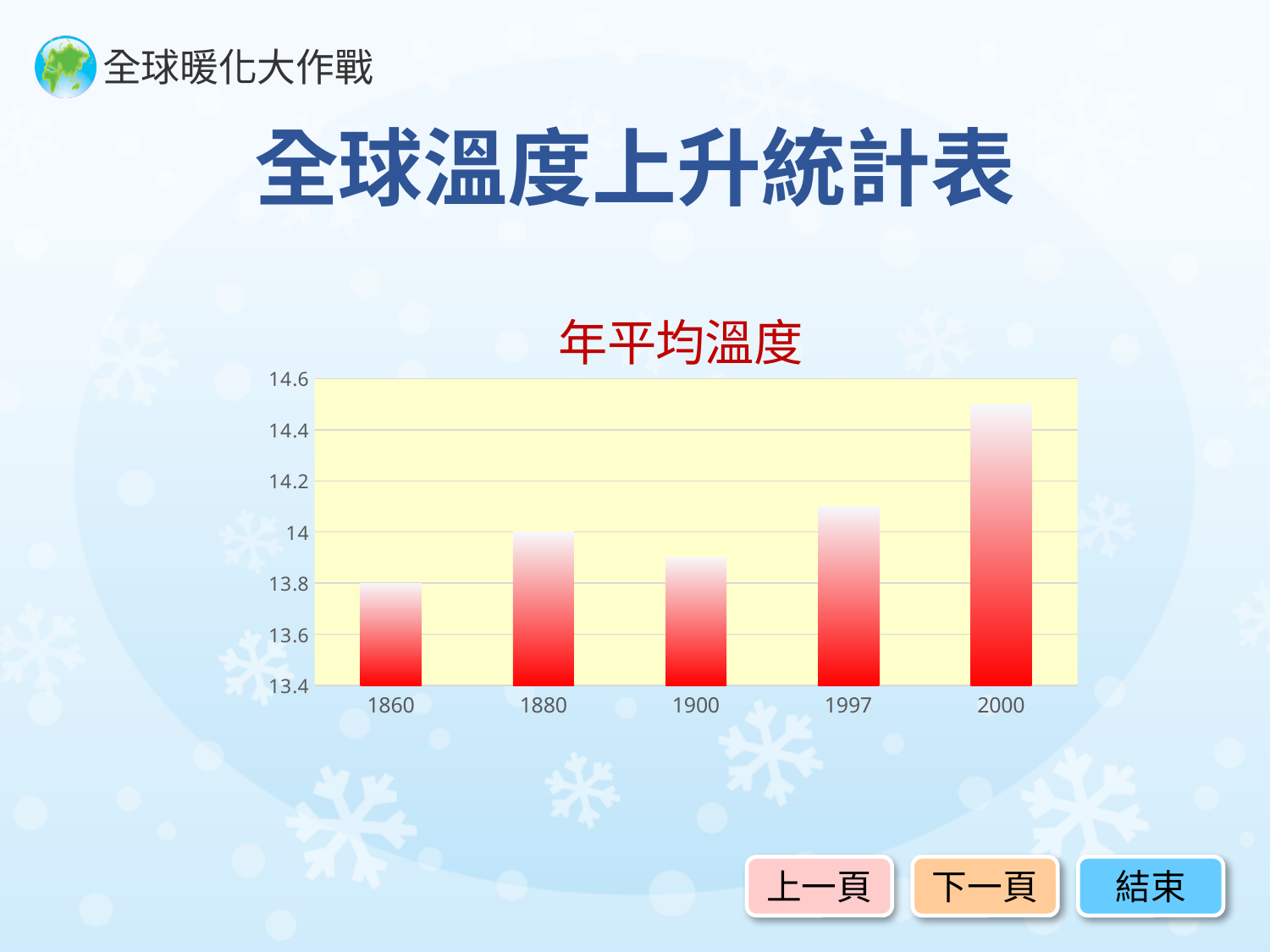
Is the value for 2000 greater or less than 14.4? greater Which year has the highest average temperature in the chart? 2000 Which is larger, the value for 1880 or the value for 1900? 1880 What is the title of the chart? 年平均溫度 How many years are shown on the x axis of the chart? 5 What is the difference between the values for 1880 and 1860? 0.2 What is the average temperature value for 1860? 13.8 What is the average temperature value for 1880? 14 Does the value rise or fall from 1997 to 2000? rise Is the value for 1997 greater or less than 14? greater What kind of chart is shown on the slide? bar chart Which year has the lowest average temperature in the chart? 1860